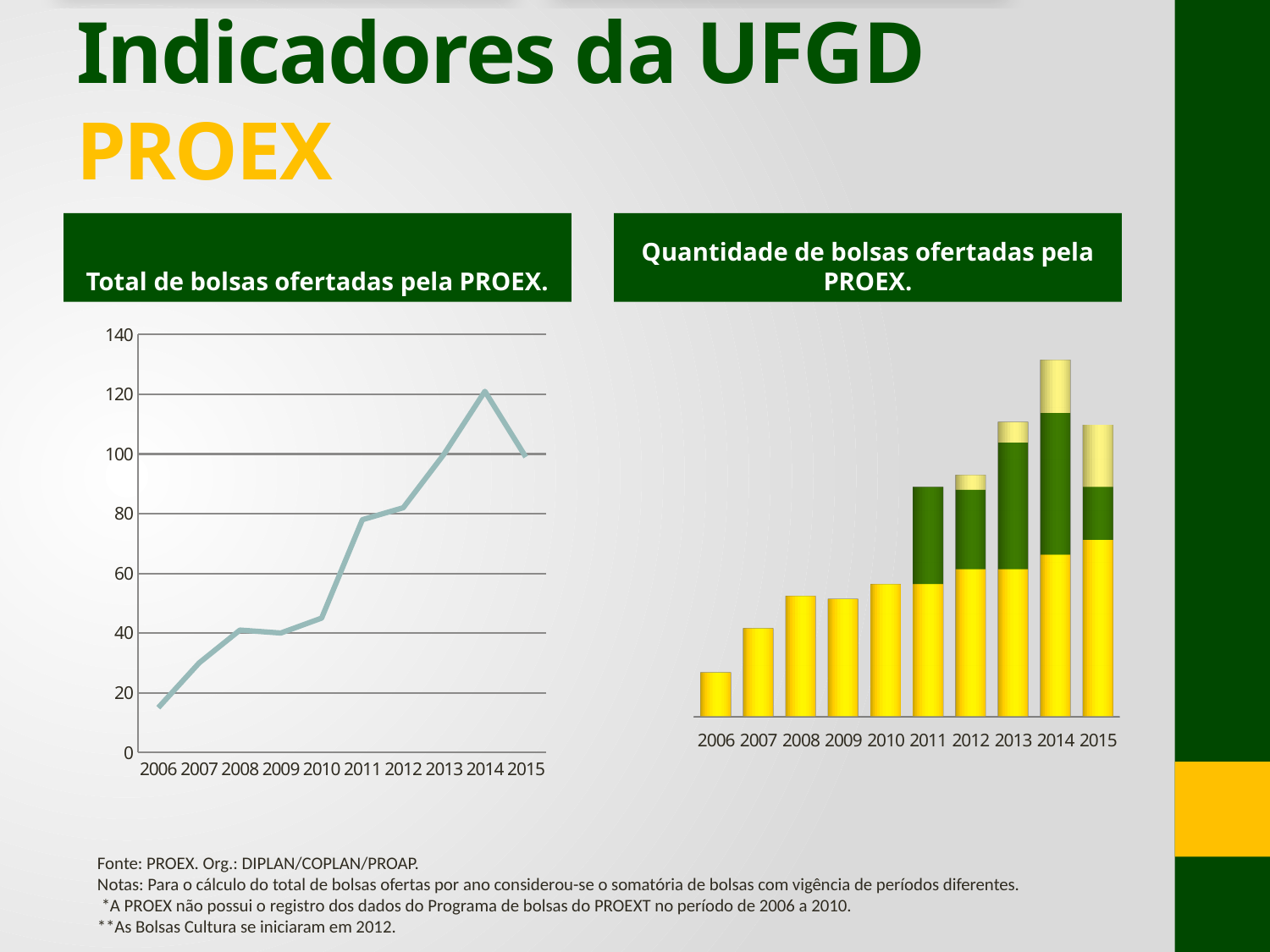
In the 'Total de bolsas ofertadas pela PROEX.' chart, how many years are shown on the x axis? 10 In the 'Total de bolsas ofertadas pela PROEX.' chart, which year has the lowest value? 2006 In the 'Total de bolsas ofertadas pela PROEX.' chart, which year has the highest value? 2014 What kind of chart is the 'Total de bolsas ofertadas pela PROEX.' chart on the left? line chart In the 'Total de bolsas ofertadas pela PROEX.' chart, which year has the larger value, 2010 or 2011? 2011 In the 'Total de bolsas ofertadas pela PROEX.' chart, is the value for 2006 greater or less than 20? less In the 'Total de bolsas ofertadas pela PROEX.' chart, do the values rise or fall from 2014 to 2015? fall In the 'Total de bolsas ofertadas pela PROEX.' chart, is the value for 2010 greater or less than 60? less In the 'Quantidade de bolsas ofertadas pela PROEX.' chart, which year has the tallest stacked bar? 2014 In the 'Total de bolsas ofertadas pela PROEX.' chart, is the value for 2011 greater or less than 60? greater What kind of chart is the 'Quantidade de bolsas ofertadas pela PROEX.' chart on the right? bar chart In the 'Quantidade de bolsas ofertadas pela PROEX.' chart, which is the first year whose bar has more than one colour segment? 2011